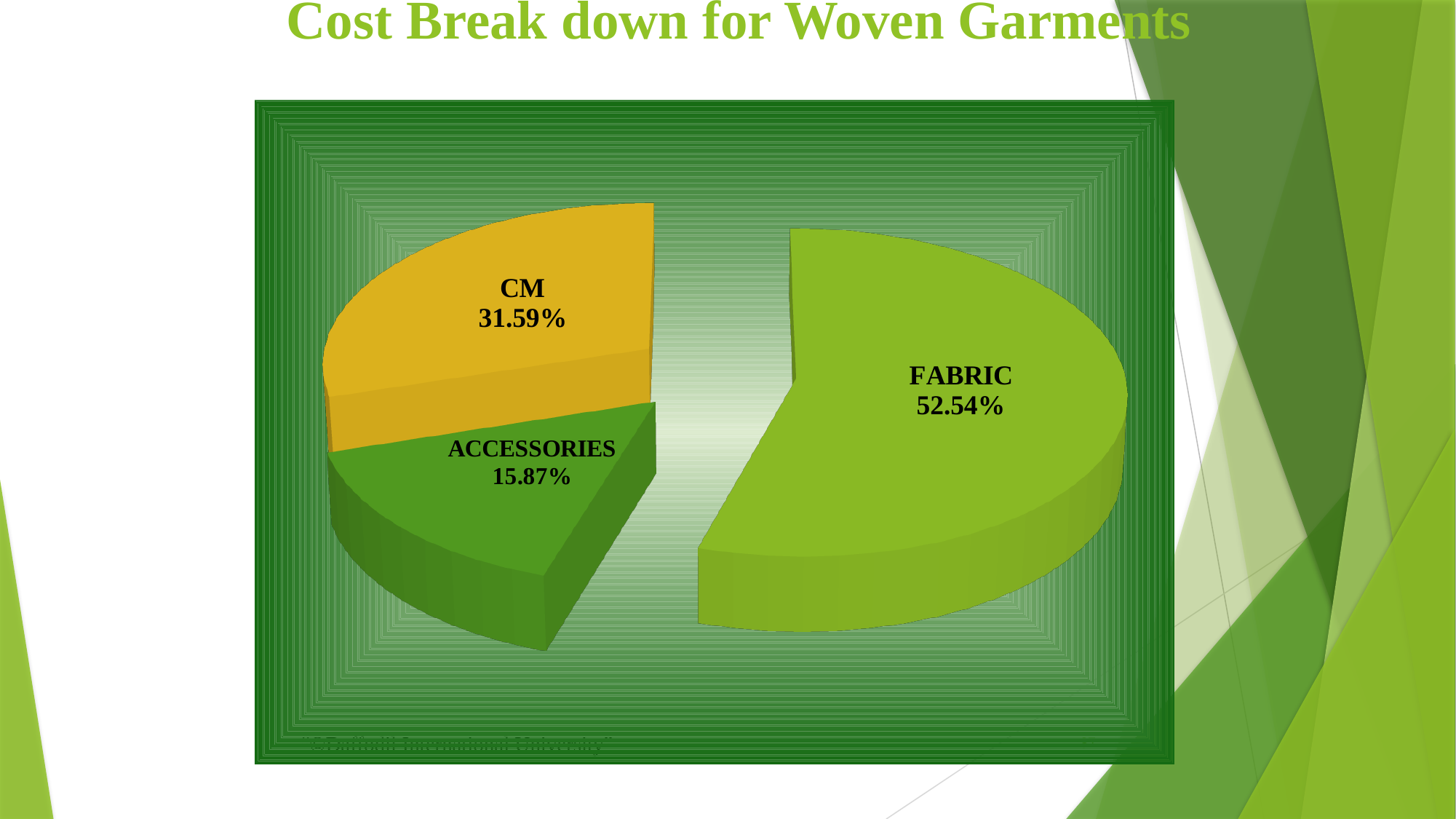
What share of the cost is CM? 31.59% Which is larger, the share for CM or the share for ACCESSORIES? CM What type of chart is shown on the slide? Pie chart How many categories are shown in the pie chart? 3 Which category has the largest share of the cost? FABRIC What is the difference between the FABRIC share and the CM share? 20.95% What share of the cost is ACCESSORIES? 15.87% Which category has the smallest share of the cost? ACCESSORIES What share of the cost is FABRIC? 52.54% What is the difference between the CM share and the ACCESSORIES share? 15.72% What is the title of the chart? Cost Break down for Woven Garments What colour is the FABRIC slice? Light green